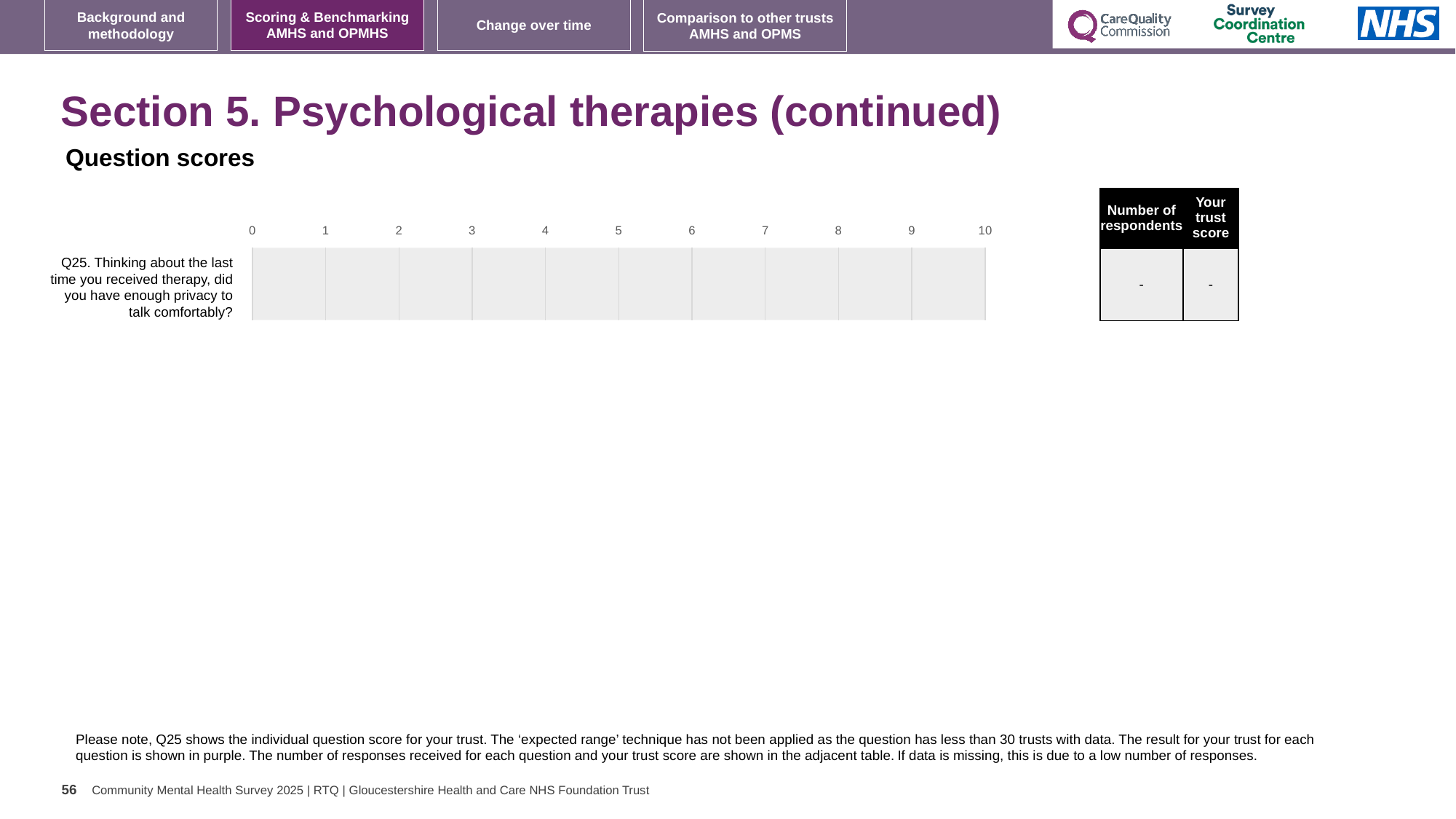
What is the highest value shown on the chart's horizontal axis? 10 Which question number is shown on the chart? Q25 What is shown in the 'Your trust score' column of the table for Q25? - What is the lowest value shown on the chart's horizontal axis? 0 Is a score bar plotted for Q25 on the chart? No What kind of chart is shown on the slide? bar chart What is shown in the 'Number of respondents' column of the table for Q25? - How many questions (categories) are listed on the chart? 1